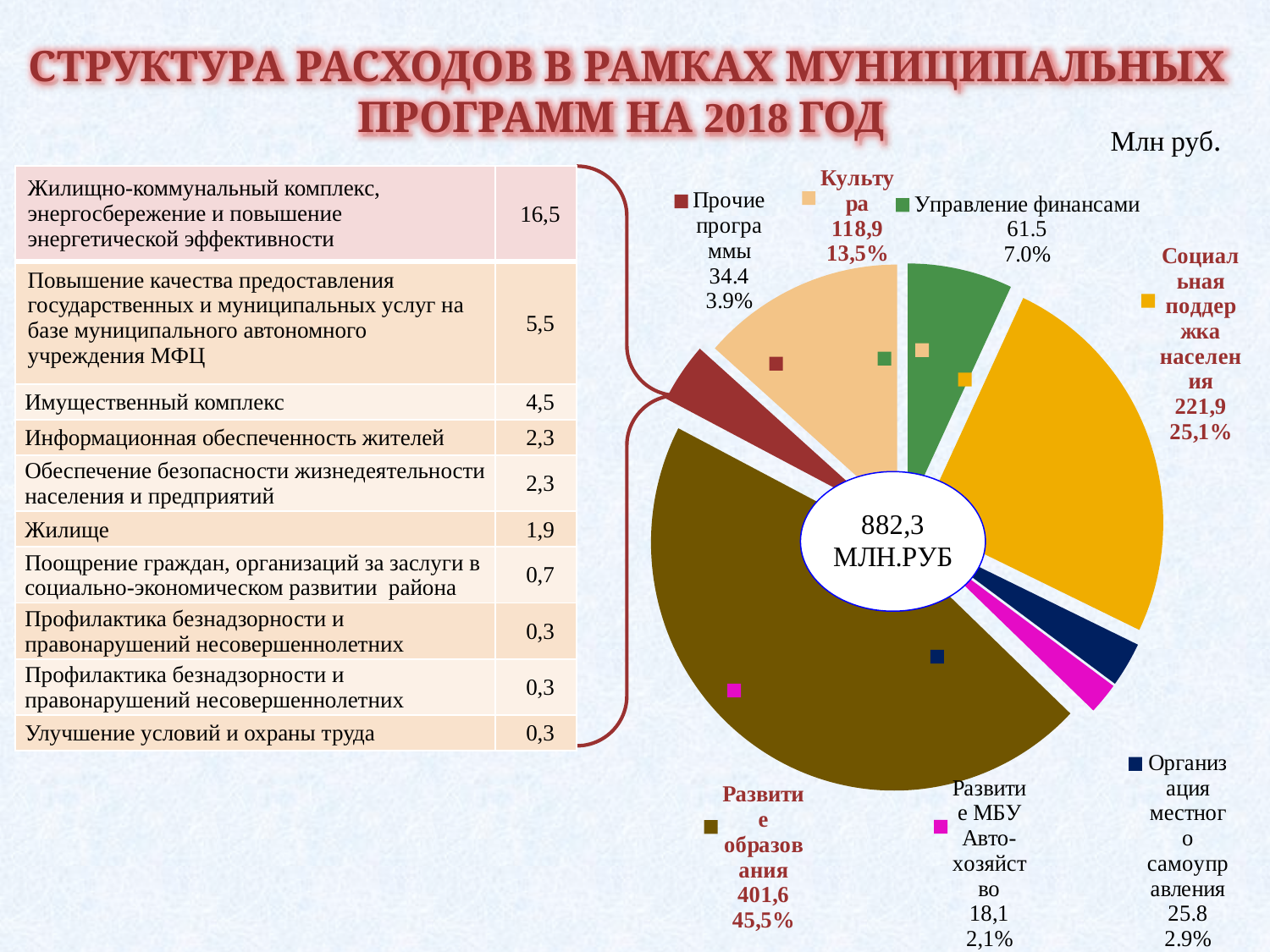
What is the value for Развитие образования in the pie chart? 401,6 What share of the pie does Социальная поддержка населения represent? 25,1% What is the value for Культура in the pie chart? 118,9 How many slices does the pie chart have? 7 What type of chart is shown on the slide? pie chart What total value is shown in the centre of the pie chart? 882,3 МЛН.РУБ Which is larger: Прочие программы or Организация местного самоуправления? Прочие программы What percentage is shown for Управление финансами? 7.0% Which category has the smallest slice of the pie? Развитие МБУ Автохозяйство Which category has the largest slice of the pie? Развитие образования What is the value for Развитие МБУ Автохозяйство? 18,1 What is the difference between the values for Социальная поддержка населения and Культура? 103,0